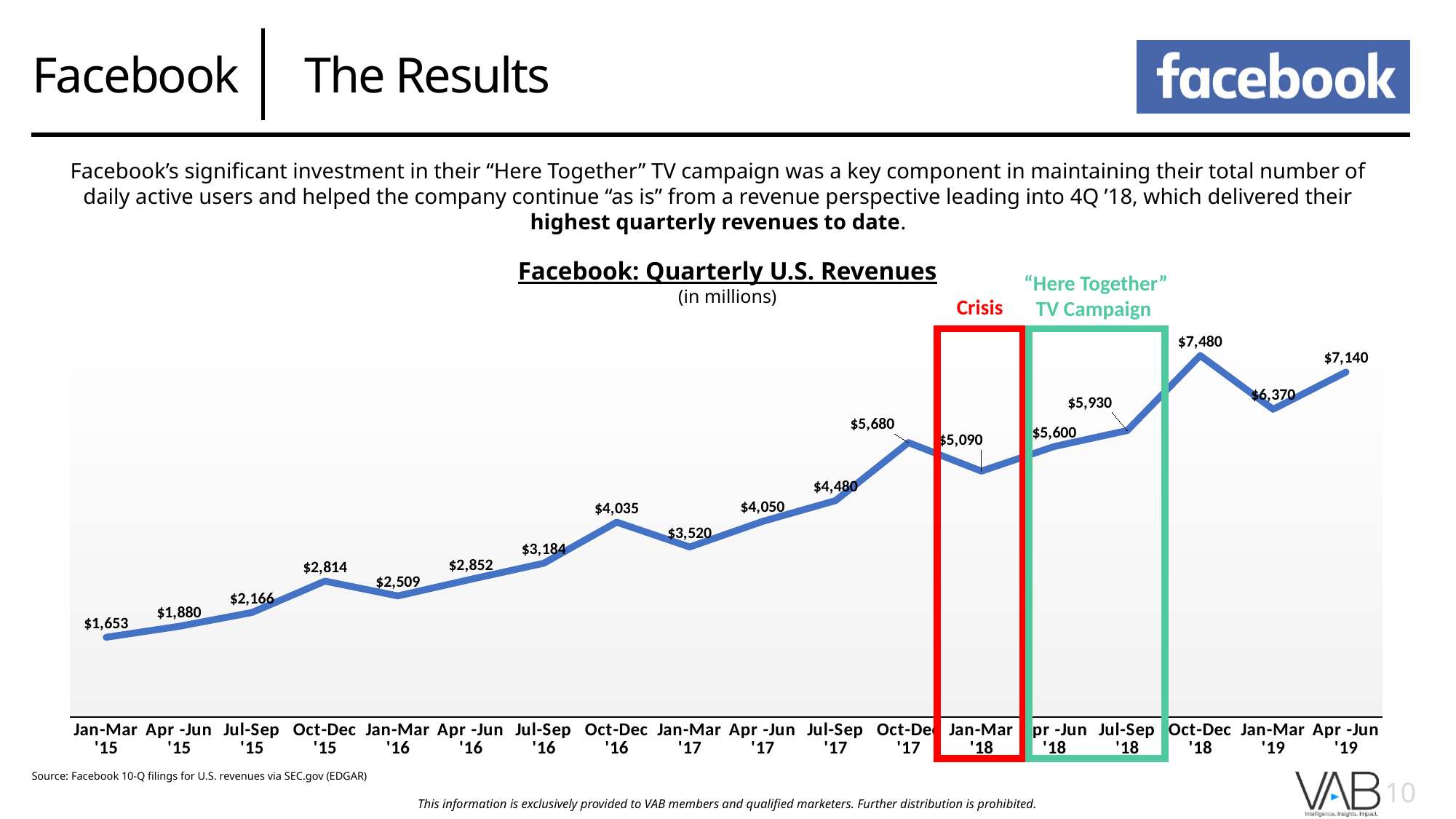
What was Facebook's quarterly U.S. revenue in Jan-Mar '15? $1,653 What is the overall trend of quarterly U.S. revenues from Jan-Mar '15 to Apr-Jun '19? Rising What was Facebook's quarterly U.S. revenue in Oct-Dec '18? $7,480 What is the difference in U.S. revenue between Oct-Dec '18 and Jan-Mar '19? $1,110 Which quarter had the lowest U.S. revenue? Jan-Mar '15 What is the difference in U.S. revenue between Oct-Dec '17 and Jan-Mar '18? $590 What was Facebook's quarterly U.S. revenue in Jan-Mar '18? $5,090 Which quarter is highlighted with the red 'Crisis' box? Jan-Mar '18 What type of chart is shown? Line chart How many quarters are plotted on the chart? 18 Which quarter had the highest U.S. revenue? Oct-Dec '18 Which quarter had higher U.S. revenue, Oct-Dec '16 or Jan-Mar '17? Oct-Dec '16